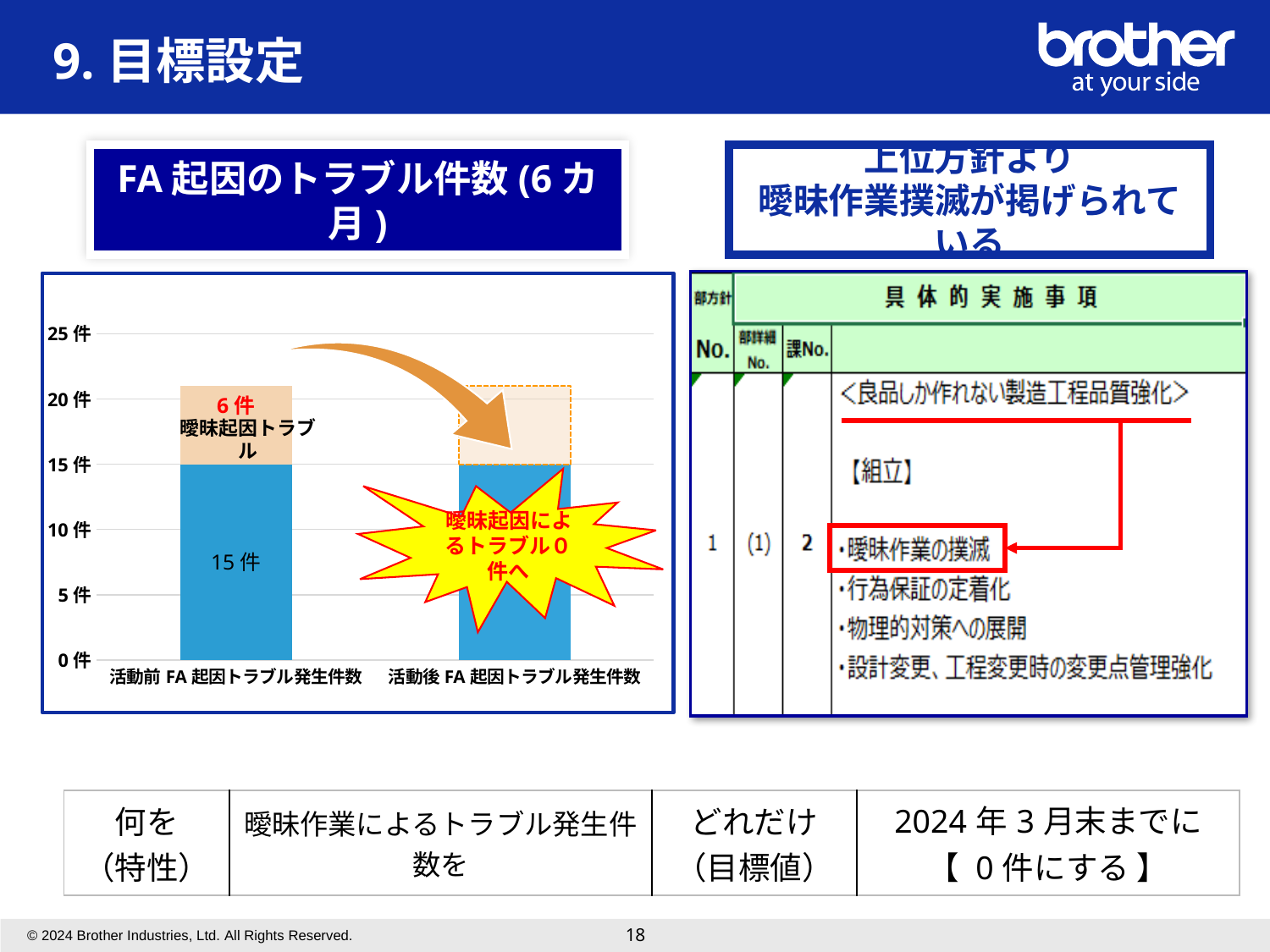
What is the highest tick label on the y axis of the chart? 25件 Is the total of the 活動前 FA起因トラブル発生件数 bar greater or less than 20件? greater What target value for 曖昧起因 trouble is shown in the starburst on the 活動後 bar? 0件 What is the value of the blue segment for 活動前 FA起因トラブル発生件数? 15件 How many categories are shown on the x axis of the chart? 2 What is the value of the 曖昧起因トラブル segment for 活動前 FA起因トラブル発生件数? 6件 Is the blue segment of the 活動後 FA起因トラブル発生件数 bar greater or less than 20件? less What is the total of the stacked bar for 活動前 FA起因トラブル発生件数? 21件 What is the title of the chart on the left? FA起因のトラブル件数(6カ月) What kind of chart is shown on the left of the slide? bar chart